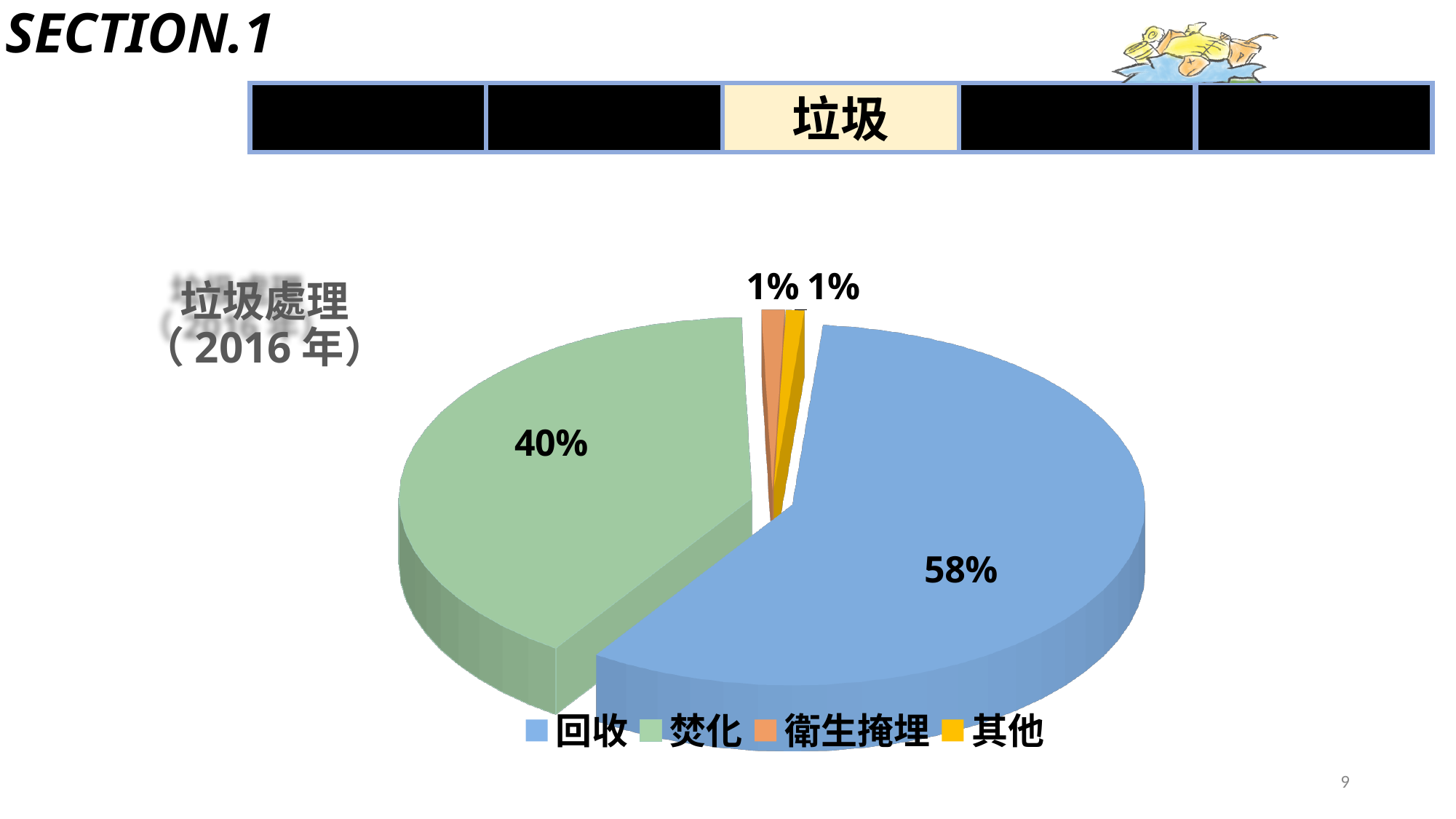
What percentage of the pie is 衛生掩埋? 1% What percentage of the pie is 其他? 1% How many entries does the legend list? 4 Which category has the largest share of the pie? 回收 Which colour represents 焚化 in the pie chart? green How many categories does the pie chart have? 4 What kind of chart is shown on the slide? pie chart What is the difference between the shares for 回收 and 焚化? 18% What percentage of the pie is 焚化? 40% Which is larger, the share for 回收 or the share for 焚化? 回收 What is the title of the pie chart? 垃圾處理（2016年） What percentage of the pie is 回收? 58%